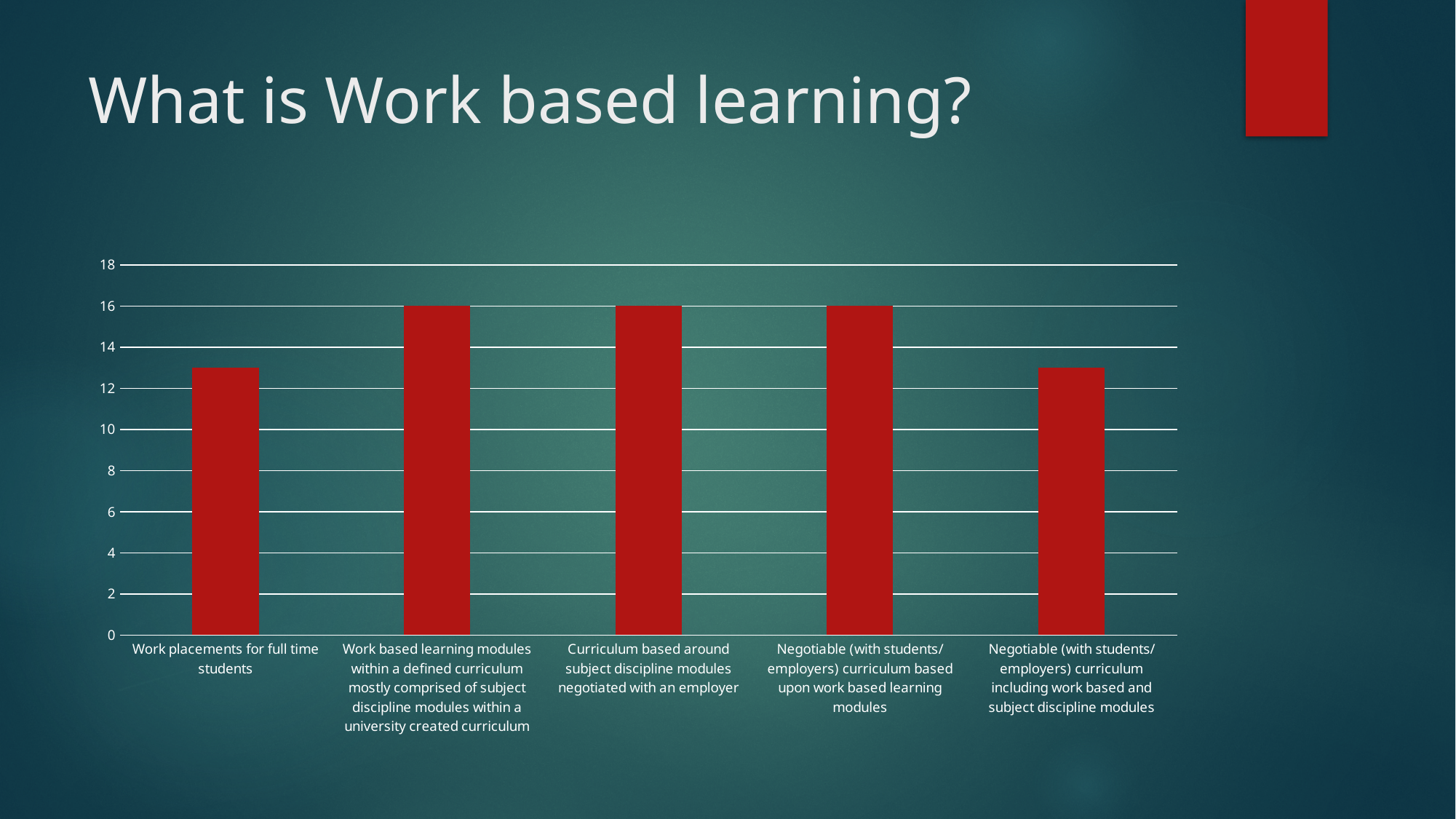
What colour are the bars in the chart? red Is the value for "Work placements for full time students" greater or less than 14? less Is the value for "Work placements for full time students" greater or less than 12? greater What is the value for "Negotiable (with students/employers) curriculum based upon work based learning modules"? 16 How many categories are plotted in the chart? 5 Is the value for "Negotiable (with students/employers) curriculum including work based and subject discipline modules" greater or less than 14? less Which is larger: the value for "Work placements for full time students" or the value for "Curriculum based around subject discipline modules negotiated with an employer"? Curriculum based around subject discipline modules negotiated with an employer What is the value for "Curriculum based around subject discipline modules negotiated with an employer"? 16 Which is larger: the value for "Negotiable (with students/employers) curriculum based upon work based learning modules" or the value for "Negotiable (with students/employers) curriculum including work based and subject discipline modules"? Negotiable (with students/employers) curriculum based upon work based learning modules What is the value for "Work based learning modules within a defined curriculum mostly comprised of subject discipline modules within a university created curriculum"? 16 What is the highest value shown on the vertical axis of the chart? 18 What kind of chart is shown on the slide? bar chart